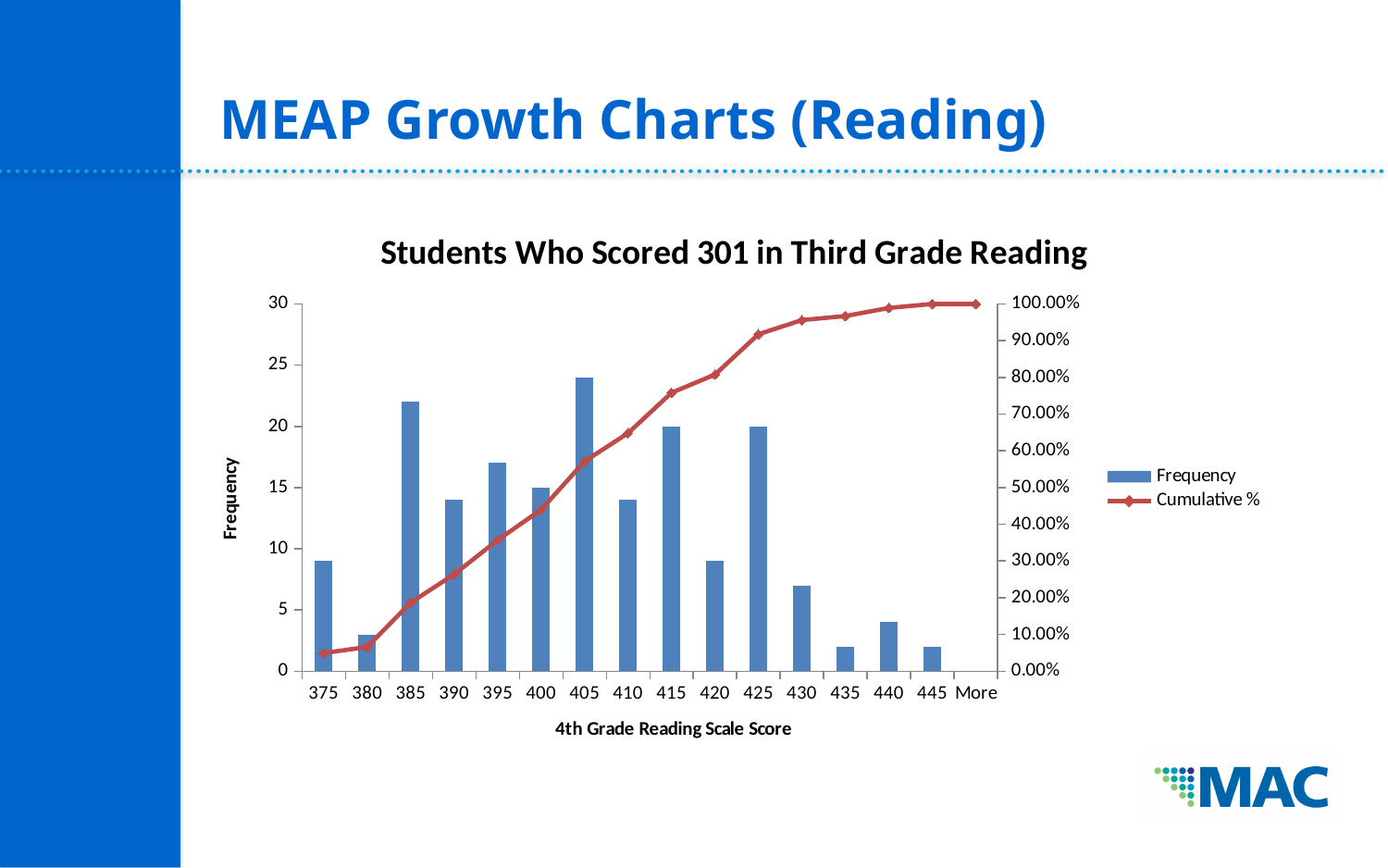
Is the frequency for the 380 score category greater or less than 5? less How many series does the legend list? 2 How many score categories are shown on the x axis? 16 Does the Cumulative % line rise or fall as the scale score increases? Rises What is the frequency for the 415 score category? 20 Which has a higher frequency, the 385 or the 390 score category? 385 What is the frequency for the 400 score category? 15 What type of chart is shown on the slide? Bar chart with a line (combination chart) Which score category has the highest frequency? 405 What is the title of the chart? Students Who Scored 301 in Third Grade Reading What is the Cumulative % value at the 'More' category? 100.00% Is the frequency for the 385 score category greater or less than 20? greater